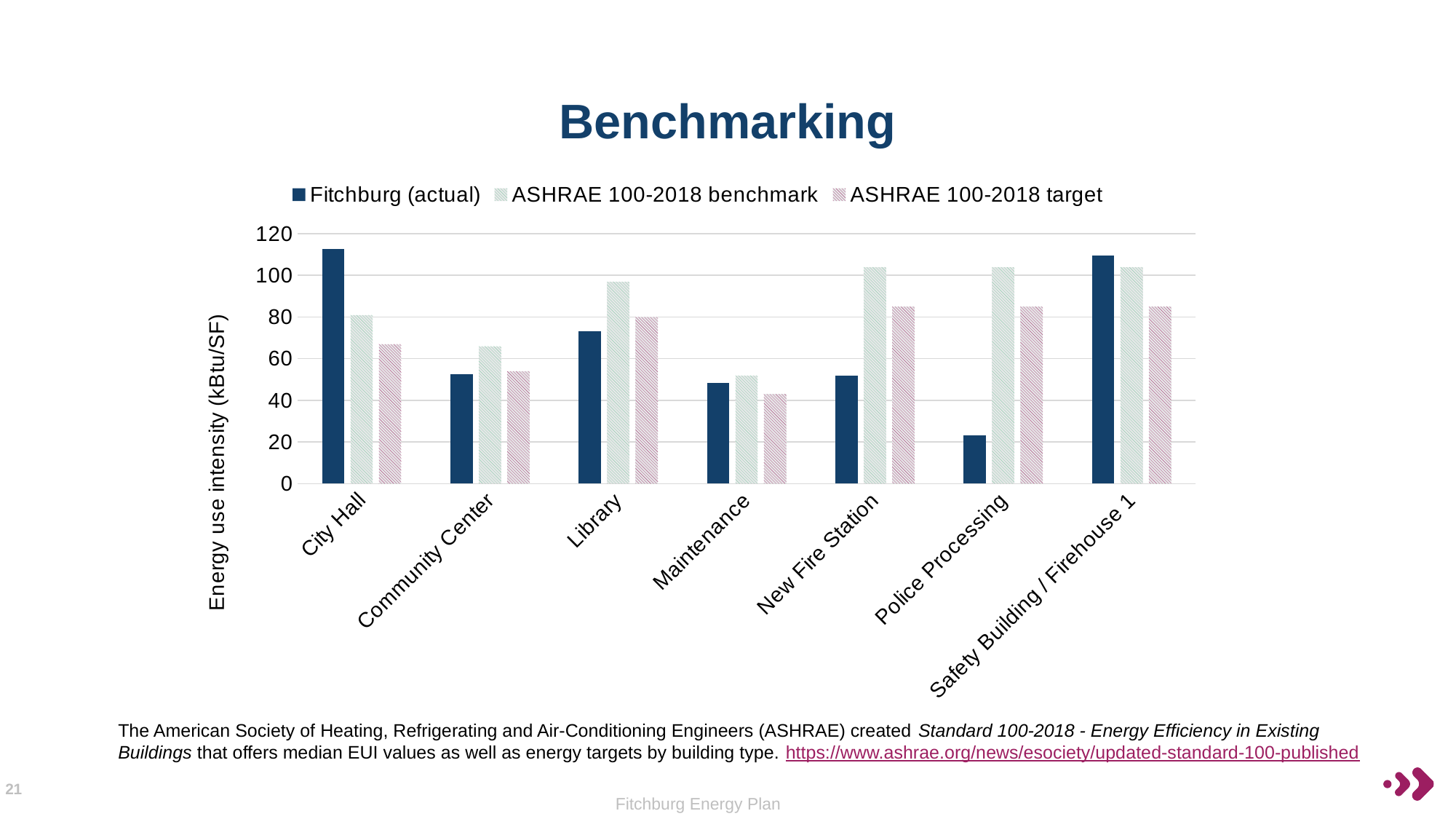
Is the ASHRAE 100-2018 benchmark value for Library greater or less than 80? greater How many series does the legend list? 3 Is the Fitchburg (actual) value for City Hall greater or less than 100? greater Is the ASHRAE 100-2018 target value for Maintenance greater or less than 60? less For City Hall, which is larger: the Fitchburg (actual) value or the ASHRAE 100-2018 benchmark value? Fitchburg (actual) For Police Processing, which is larger: the Fitchburg (actual) value or the ASHRAE 100-2018 benchmark value? ASHRAE 100-2018 benchmark What kind of chart is shown on the slide? bar chart How many buildings are shown on the x axis? 7 What is the label on the y axis? Energy use intensity (kBtu/SF) Which building has the lowest Fitchburg (actual) value? Police Processing What is the title of the chart? Benchmarking